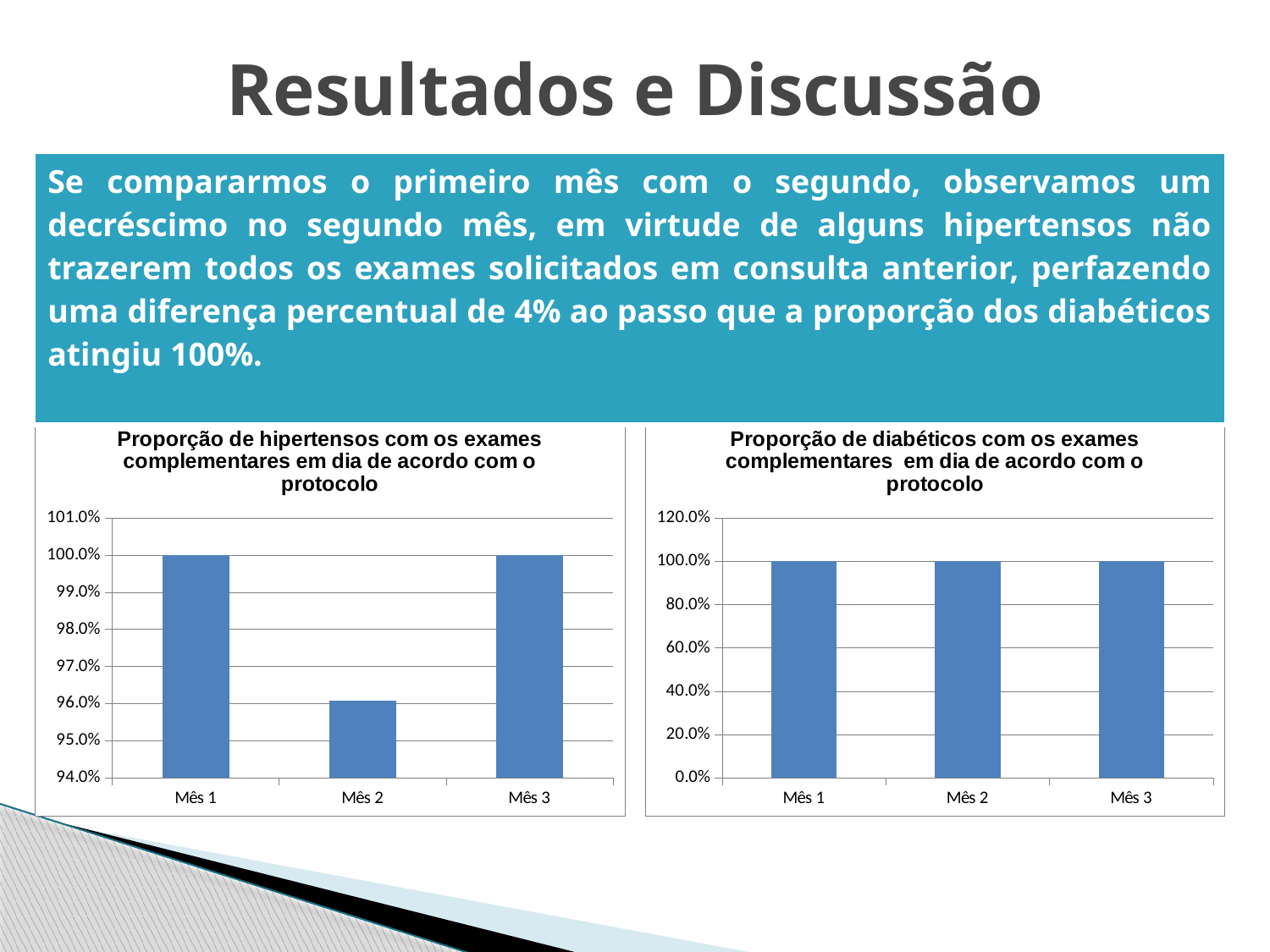
In the left chart (Proporção de hipertensos), how many months are shown on the x axis? 3 What is the title of the left chart? Proporção de hipertensos com os exames complementares em dia de acordo com o protocolo What kind of chart is the right chart (Proporção de diabéticos)? bar chart In the right chart (Proporção de diabéticos), what is the value for Mês 3? 100.0% In the left chart (Proporção de hipertensos), what is the value for Mês 3? 100.0% In the left chart (Proporção de hipertensos), do the values rise or fall from Mês 1 to Mês 2? fall In the left chart (Proporção de hipertensos), which is larger, the value for Mês 1 or the value for Mês 2? Mês 1 In the left chart (Proporção de hipertensos), is the value for Mês 2 greater or less than 97.0%? less In the left chart (Proporção de hipertensos), what is the value for Mês 1? 100.0% In the right chart (Proporção de diabéticos), what is the value for Mês 2? 100.0% In the right chart (Proporção de diabéticos), is the value for Mês 1 greater or less than 80.0%? greater In the left chart (Proporção de hipertensos), which month has the lowest value? Mês 2